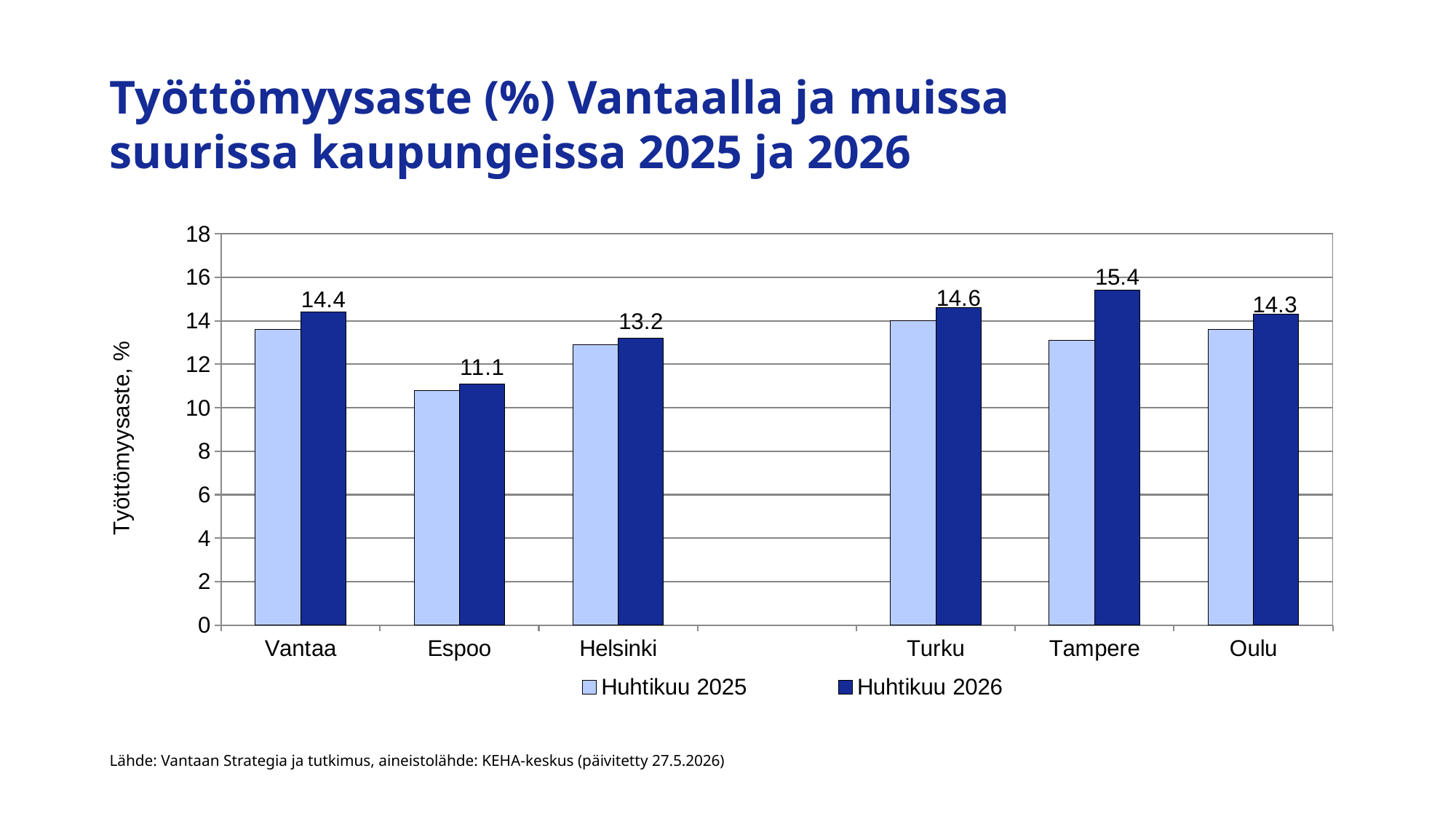
What is the difference between the Huhtikuu 2026 unemployment rates of Tampere and Espoo? 4.3 How many series does the legend list? 2 Is the Huhtikuu 2025 value for Vantaa greater or less than 12? greater What is the unemployment rate for Espoo in Huhtikuu 2026? 11.1 What is the unemployment rate for Helsinki in Huhtikuu 2026? 13.2 What is the unemployment rate for Tampere in Huhtikuu 2026? 15.4 In Huhtikuu 2026, which has the higher unemployment rate, Turku or Oulu? Turku Is the Huhtikuu 2025 value for Espoo greater or less than 12? less How many cities are shown on the x axis of the chart? 6 Which city has the lowest unemployment rate in Huhtikuu 2026? Espoo Which city has the highest unemployment rate in Huhtikuu 2026? Tampere What kind of chart is shown on the slide? Bar chart